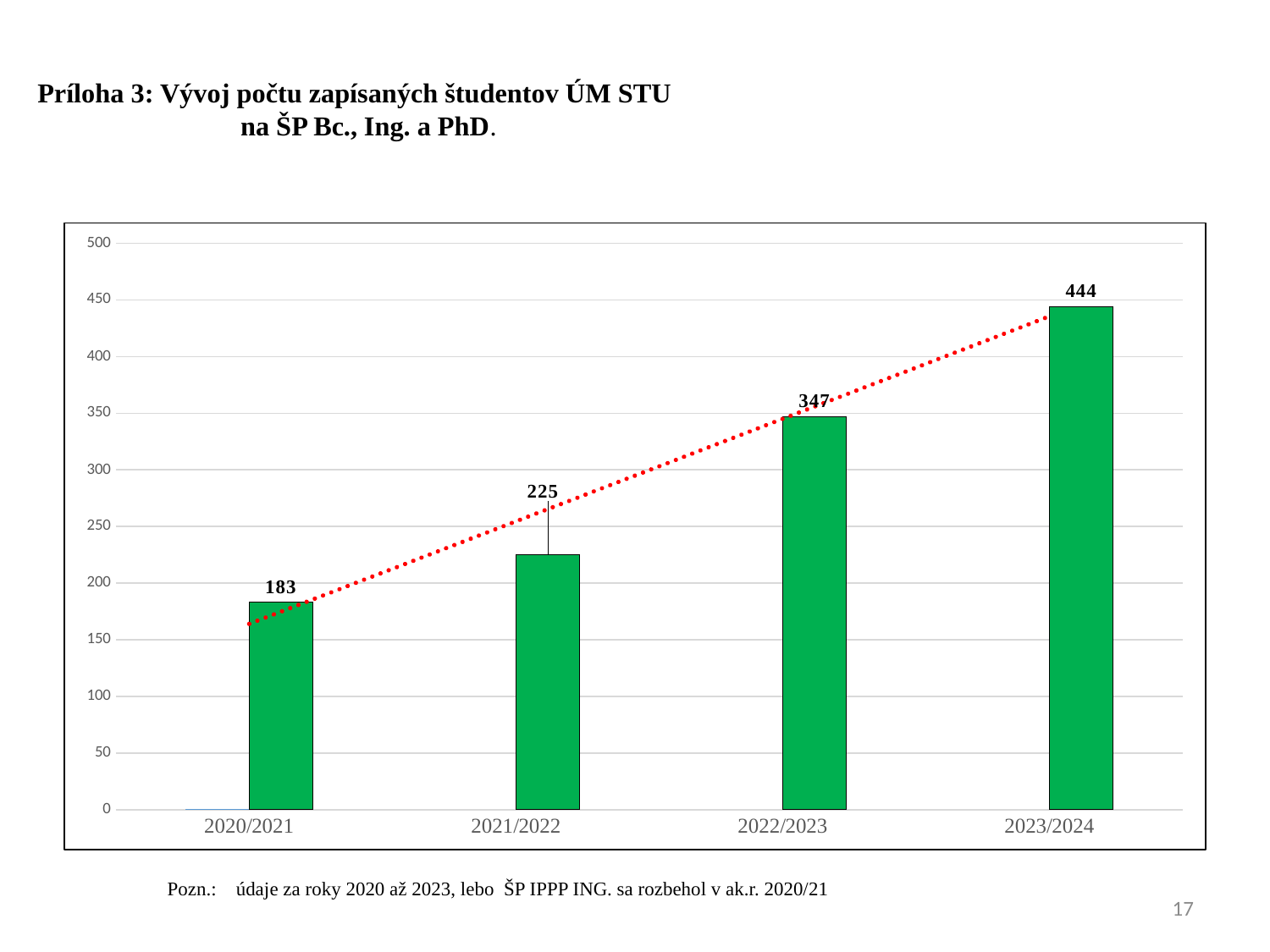
What kind of chart is this? bar chart What is the value for 2023/2024? 444 What is the value for 2020/2021? 183 What is the value for 2021/2022? 225 What is the difference between the values for 2023/2024 and 2022/2023? 97 Which academic year has the lowest value? 2020/2021 What is the difference between the values for 2021/2022 and 2020/2021? 42 What is the value for 2022/2023? 347 How many academic years are shown on the x axis? 4 Do the values rise or fall from 2020/2021 to 2023/2024? rise Which academic year has the highest value? 2023/2024 Which is larger, the value for 2022/2023 or the value for 2021/2022? 2022/2023